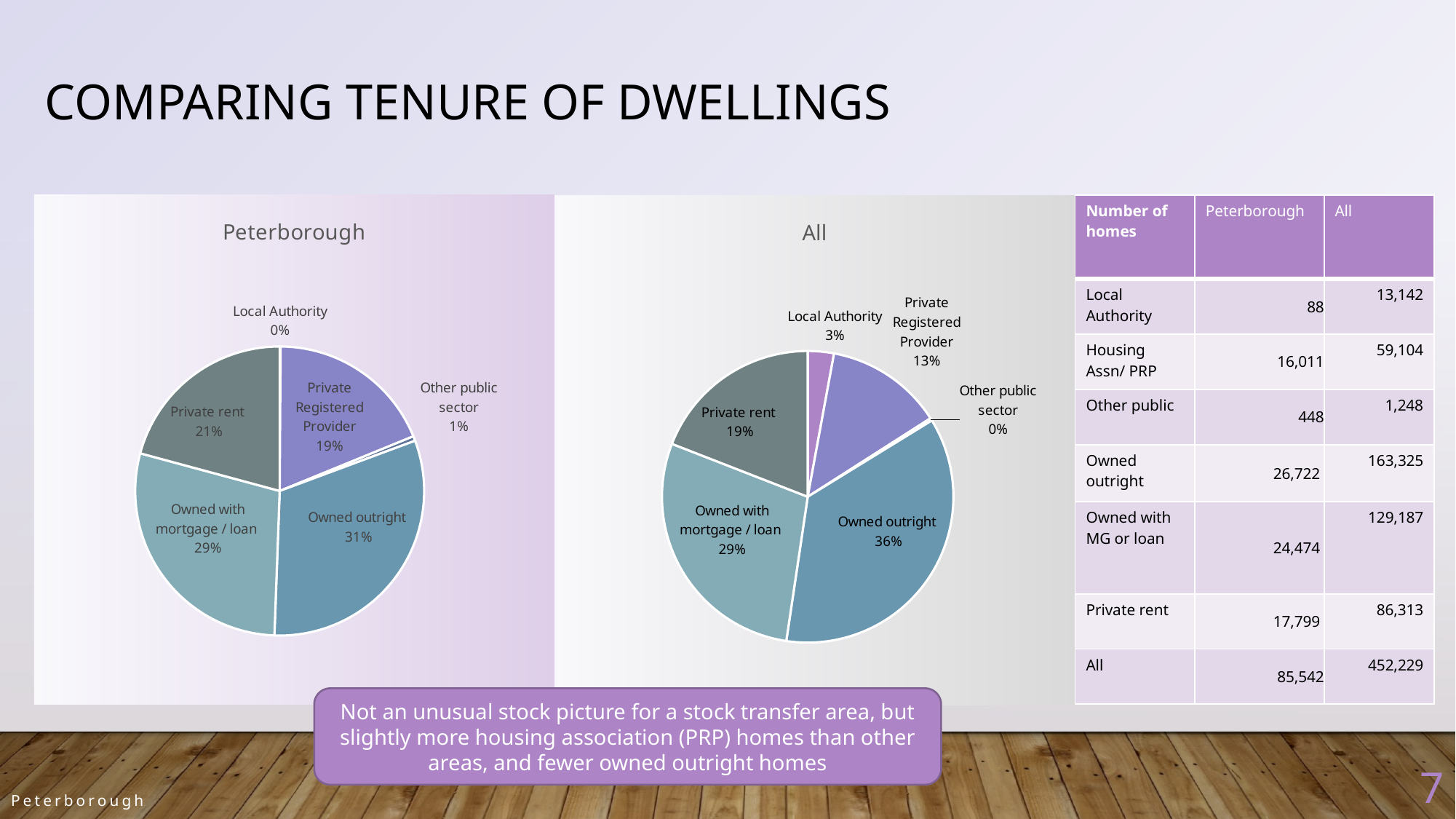
What type of chart is used for the Peterborough data? Pie chart In the All pie chart, which category has the largest share? Owned outright What is the difference in percentage points between Owned outright in the All chart and Owned outright in the Peterborough chart? 5 percentage points In the All pie chart, what share is Private Registered Provider? 13% In the Peterborough pie chart, which category has the smallest share? Local Authority In the All pie chart, what share is Local Authority? 3% How many categories are shown in the Peterborough pie chart? 6 What is the title of the pie chart on the left? Peterborough Which is larger: Private Registered Provider in the Peterborough chart or Private Registered Provider in the All chart? Peterborough In the Peterborough pie chart, what share is Owned outright? 31% In the Peterborough pie chart, what share is Private rent? 21% In the Peterborough pie chart, what share is Owned with mortgage / loan? 29%